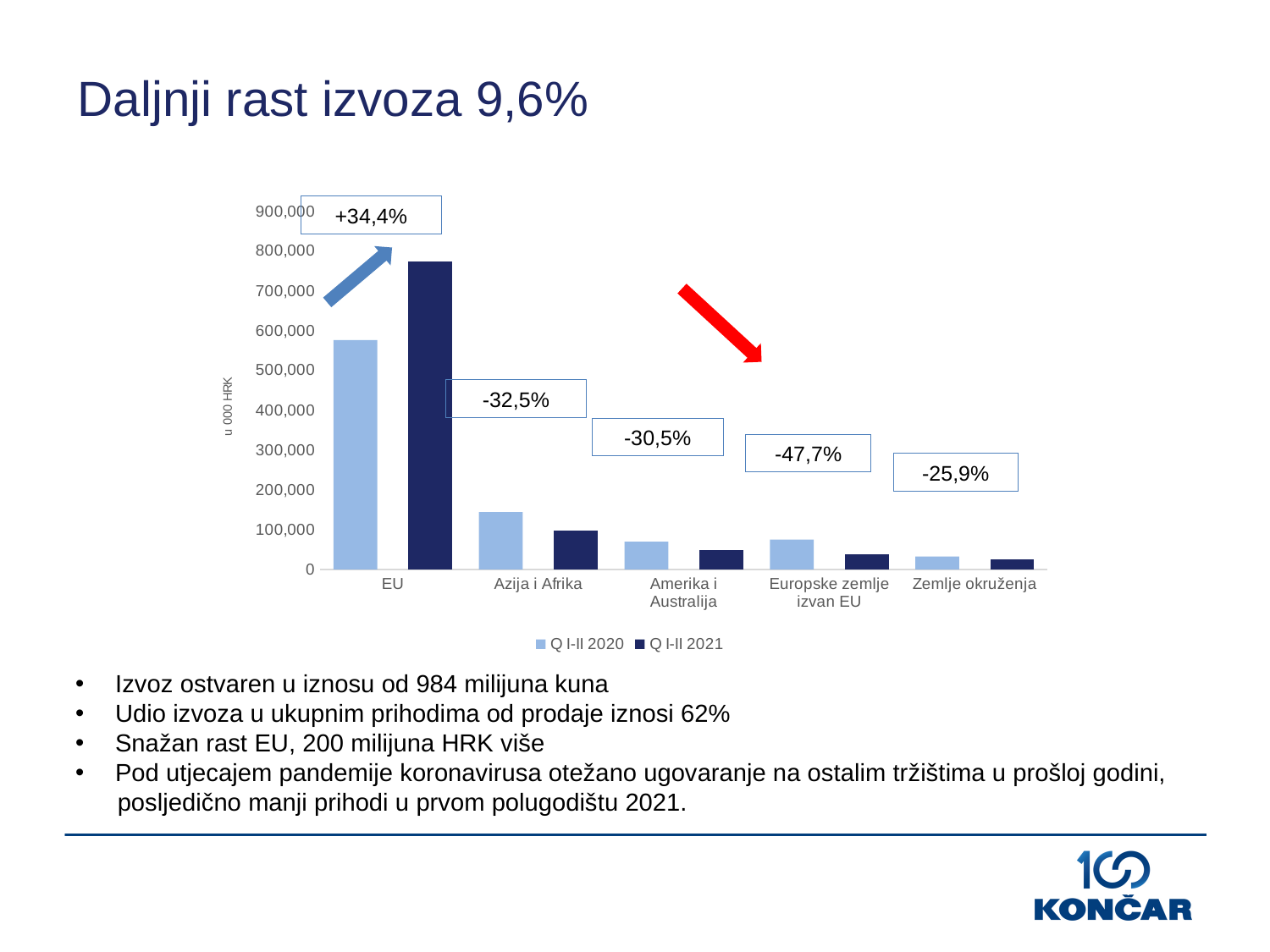
For EU, which is larger: the Q I-II 2020 value or the Q I-II 2021 value? Q I-II 2021 How many categories are shown on the x axis of the chart? 5 Is the Q I-II 2021 value for EU greater or less than 700,000? greater What percentage change is annotated above the EU bars? +34,4% For Azija i Afrika, which is larger: the Q I-II 2020 value or the Q I-II 2021 value? Q I-II 2020 Which category has the lowest value for Q I-II 2020? Zemlje okruženja What percentage change is annotated for Europske zemlje izvan EU? -47,7% How many series does the chart legend list? 2 Is the Q I-II 2020 value for Azija i Afrika greater or less than 200,000? less What kind of chart is shown on the slide? bar chart What unit is shown on the vertical axis label of the chart? u 000 HRK Which category has the highest value for Q I-II 2021? EU